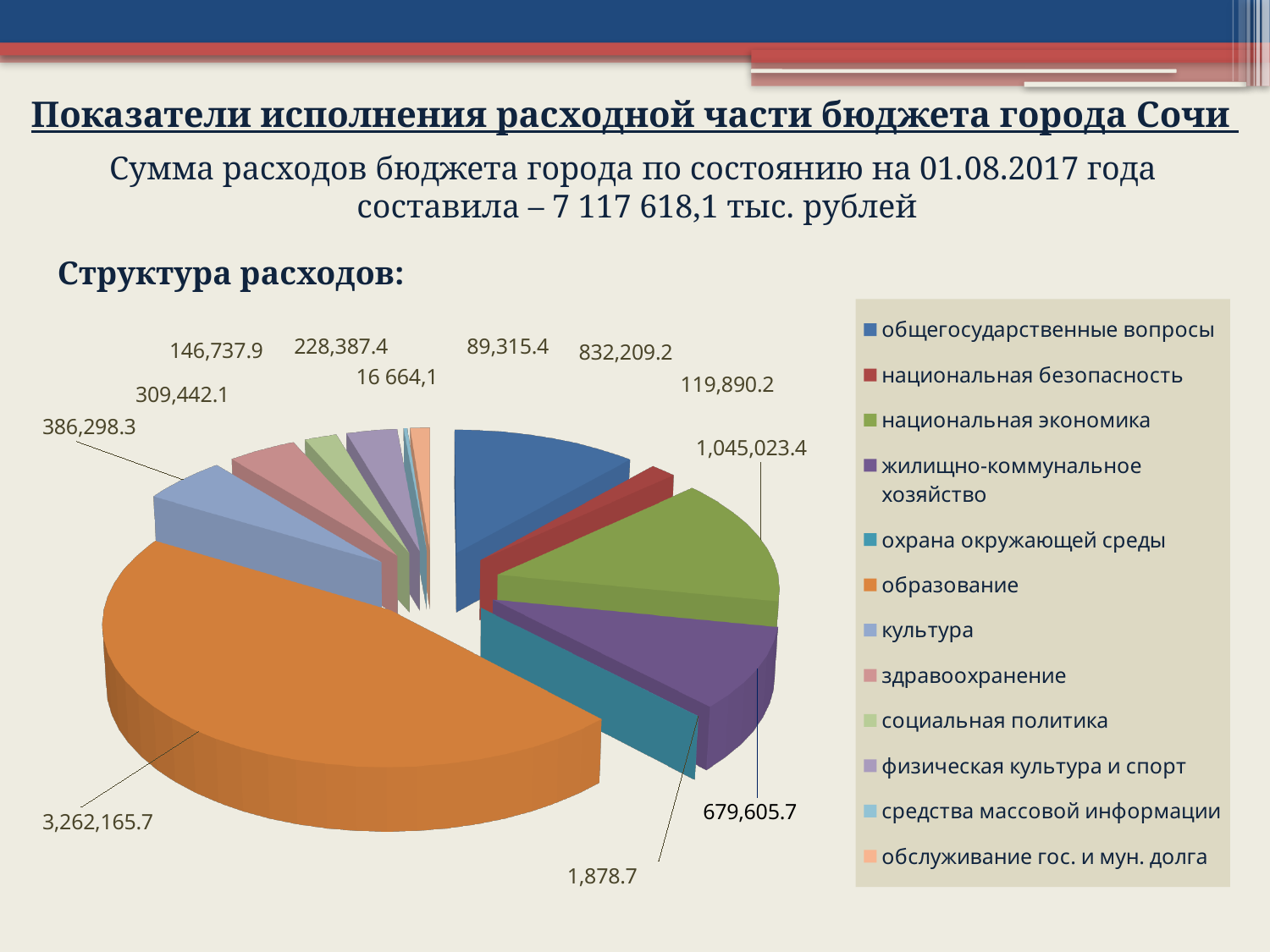
What is the difference between the values for национальная экономика and общегосударственные вопросы? 212,814.2 What is the value shown for охрана окружающей среды? 1,878.7 What is the title of the section above the pie chart? Структура расходов: Which category has the smallest slice of the pie? охрана окружающей среды What is the value shown for жилищно-коммунальное хозяйство? 679,605.7 What is the value shown for образование? 3,262,165.7 How many categories does the legend of the pie chart list? 12 What kind of chart is shown on the slide? pie chart What is the value shown for культура? 386,298.3 What is the value shown for национальная экономика? 1,045,023.4 Which category has the largest slice of the pie? образование Which is larger, общегосударственные вопросы or национальная экономика? национальная экономика